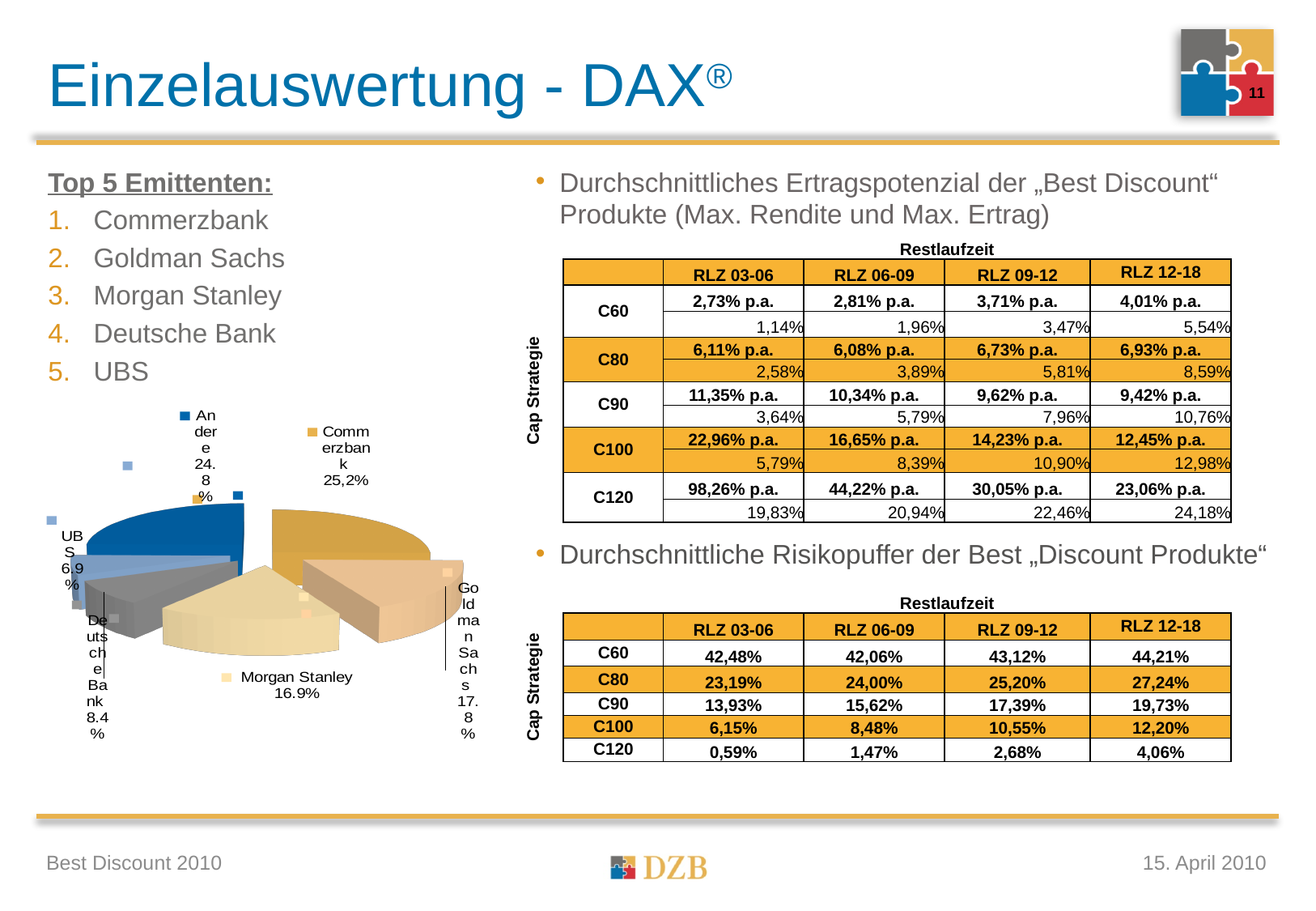
Which slice of the pie chart has the largest share? Commerzbank In the pie chart, what share is shown for UBS? 6.9% In the pie chart, what share is shown for Andere? 24.8% In the pie chart, which has the larger share, Goldman Sachs or Morgan Stanley? Goldman Sachs What kind of chart is shown on the left of the slide? Pie chart In the pie chart, what share is shown for Goldman Sachs? 17.8% How many slices does the pie chart have? 6 In the pie chart, what share is shown for Morgan Stanley? 16.9% Which slice of the pie chart has the smallest share? UBS In the pie chart, what share is shown for Deutsche Bank? 8.4% In the pie chart, what share is shown for Commerzbank? 25,2% In the pie chart, what is the difference between the shares of Deutsche Bank and UBS? 1.5%